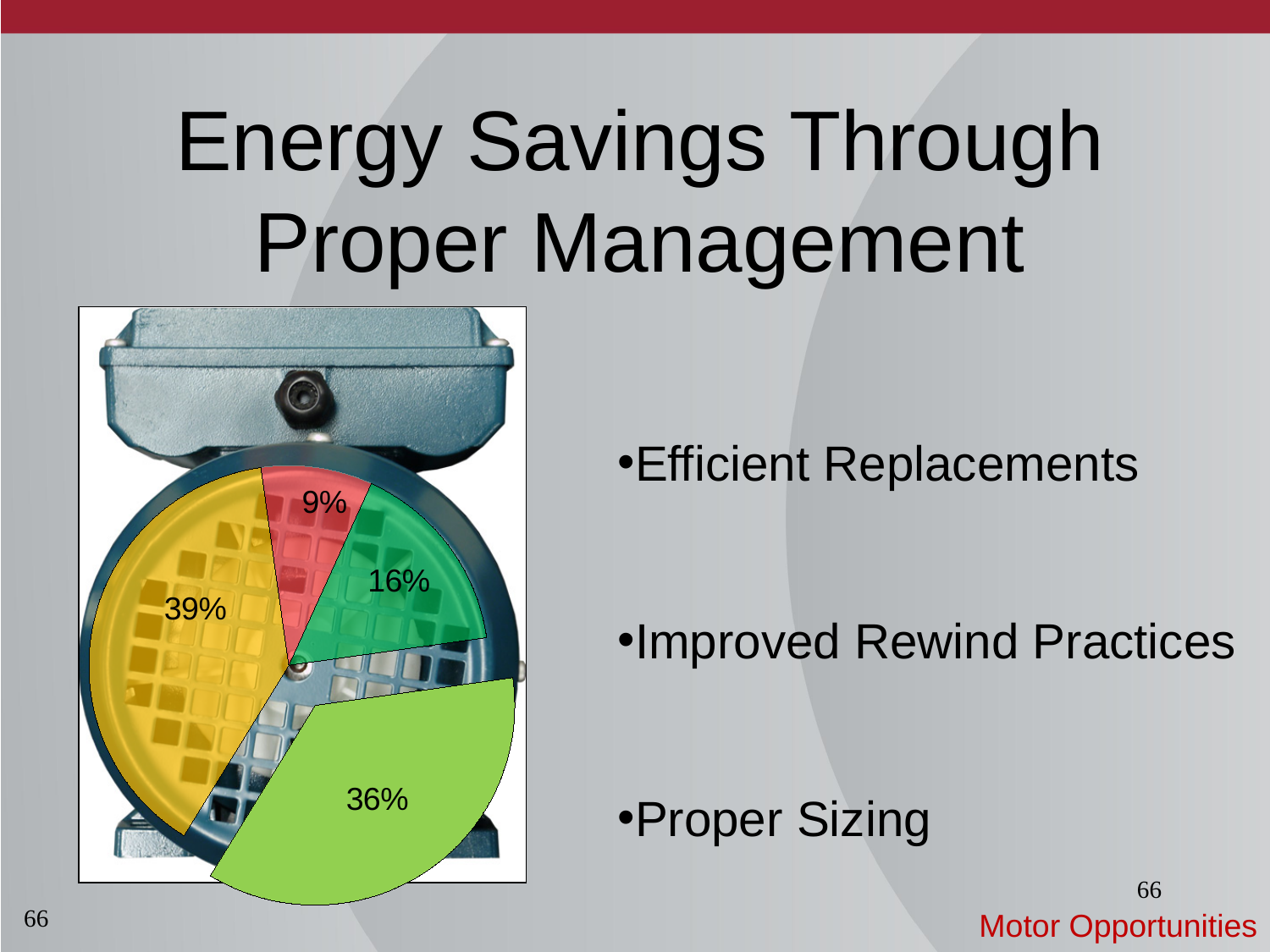
Which slice of the pie chart is the largest? the yellow slice (39%) What percentage is shown on the light green slice of the pie chart? 36% What percentage is shown on the dark green slice of the pie chart? 16% How many slices does the pie chart have? 4 What kind of chart is shown on the slide? pie chart What percentage is shown on the yellow slice of the pie chart? 39% What is the difference in percentage points between the yellow slice and the light green slice? 3 percentage points What is the title of the slide containing the pie chart? Energy Savings Through Proper Management Which is larger, the dark green slice or the red slice? the dark green slice Which slice of the pie chart is the smallest? the red slice (9%) What percentage is shown on the red slice of the pie chart? 9% What is the difference in percentage points between the dark green slice and the red slice? 7 percentage points